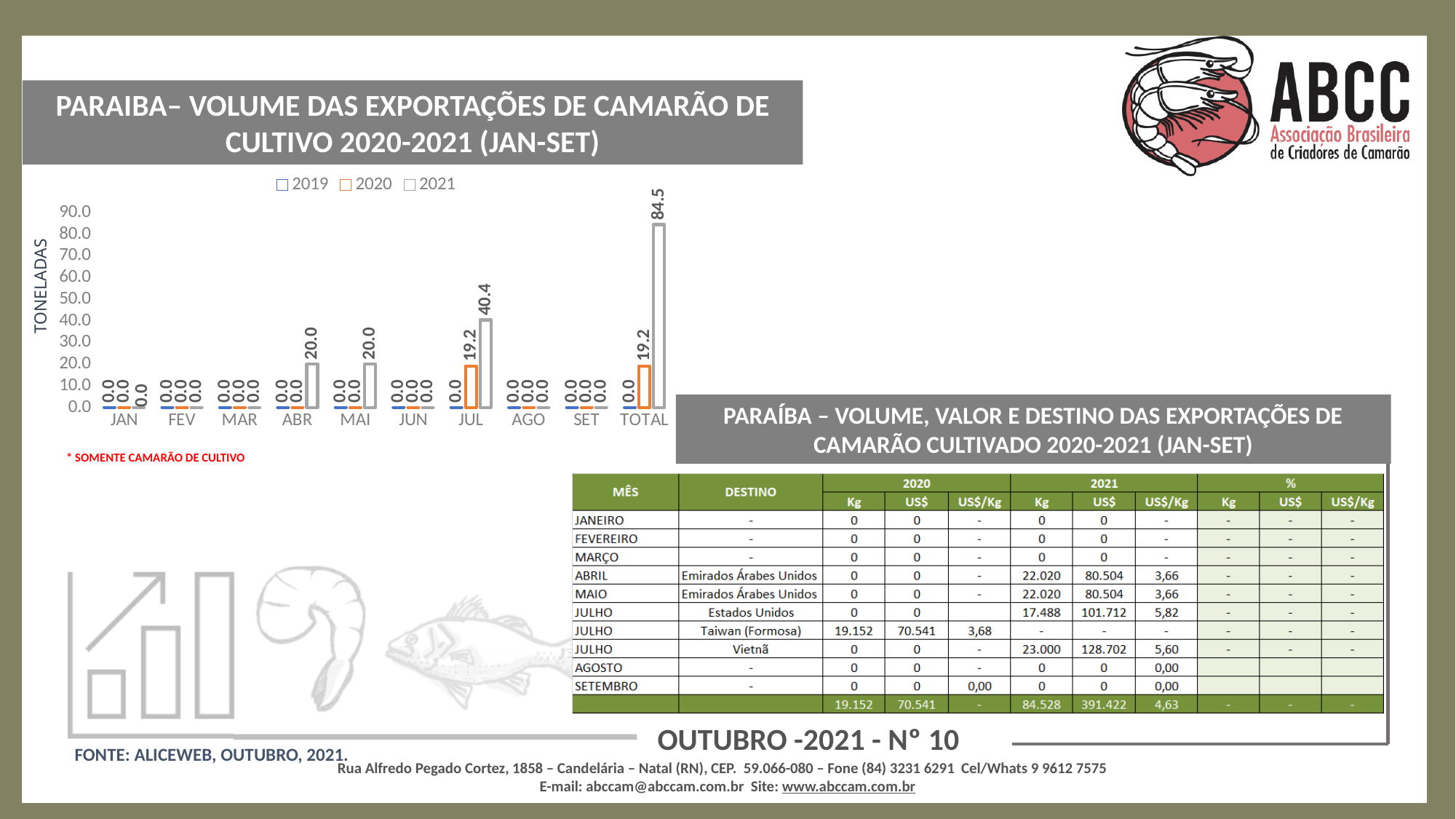
How many categories are shown on the x axis of the chart? 10 Which is larger in the chart: the 2021 value for JUL or the 2020 value for JUL? 2021 What is the 2021 value for JUL in the chart? 40.4 What is the difference between the 2021 values for JUL and MAI in the chart? 20.4 What is the 2021 value for ABR in the chart? 20.0 What is the difference between the 2021 and 2020 values for TOTAL in the chart? 65.3 What label is shown on the vertical axis of the chart? TONELADAS What is the 2021 value for TOTAL in the chart? 84.5 What type of chart is shown on the slide? bar chart How many series does the chart legend list? 3 What is the 2020 value for JUL in the chart? 19.2 Which month has the highest 2021 value in the chart (excluding TOTAL)? JUL